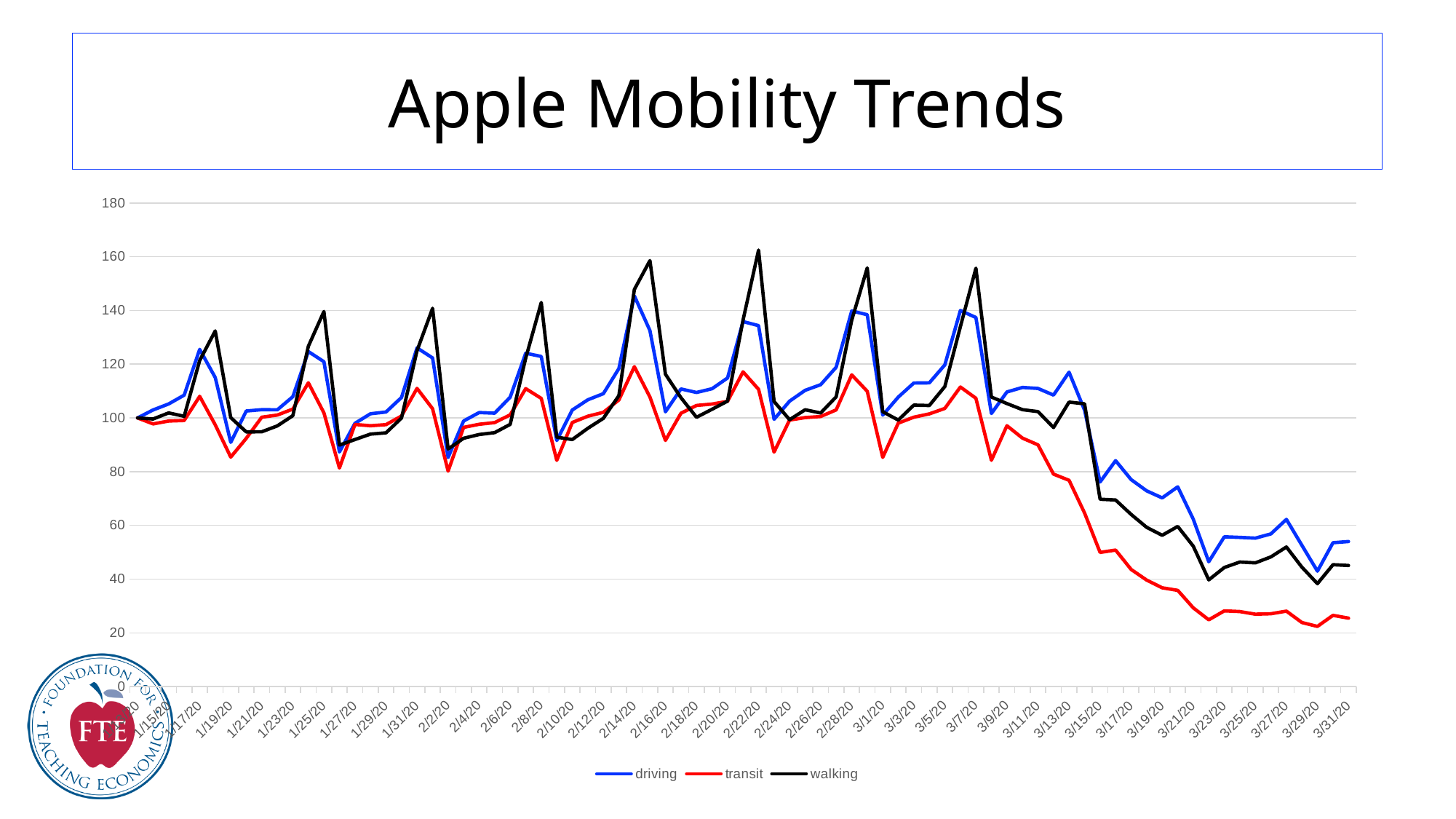
Which colour is used for the transit series? red How many series does the legend list? 3 Is the value for driving on 3/31/20 greater or less than 40? greater Do the transit values rise or fall from 3/13/20 to 3/31/20? fall What kind of chart is shown on the slide? line chart On 3/31/20, which is larger, the driving value or the transit value? driving On 2/22/20, which is larger, the walking value or the transit value? walking Is the value for transit on 3/31/20 greater or less than 40? less Is the value for transit on 3/23/20 greater or less than 40? less What is the title of the chart? Apple Mobility Trends Which series has the lowest value on 3/31/20? transit